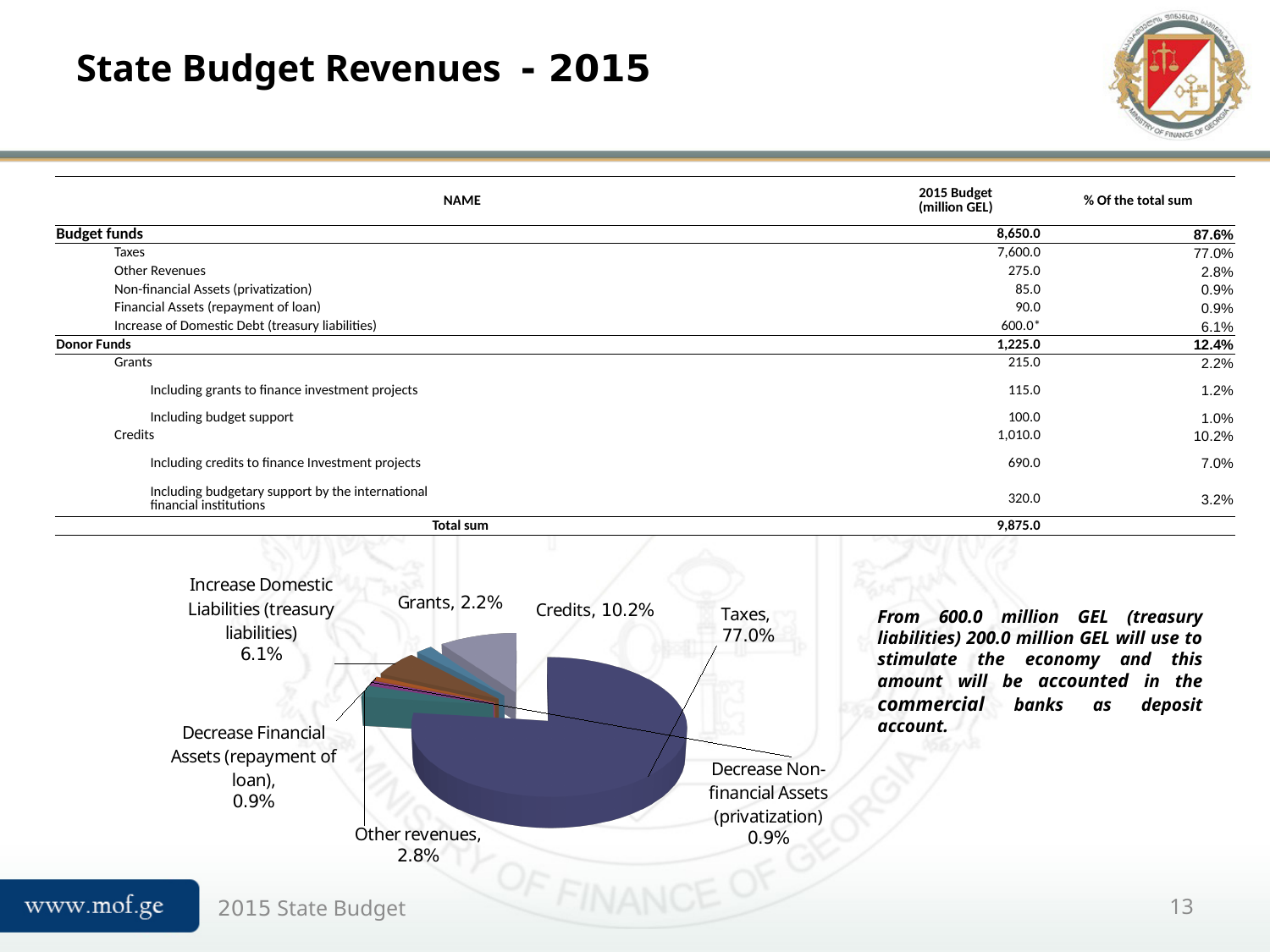
How many slices does the pie chart have? 7 In the pie chart, which is larger: Credits or Grants? Credits What share of the pie chart does Grants represent? 2.2% What is the combined share of Grants and Credits in the pie chart? 12.4% What share of the pie chart does Other revenues represent? 2.8% Which slice of the pie chart is the largest? Taxes What type of chart is shown on the slide? Pie chart What share of the pie chart does Credits represent? 10.2% What share of the pie chart does Taxes represent? 77.0% What is the difference in percentage points between the Taxes slice and the Credits slice in the pie chart? 66.8 What share of the pie chart does Increase Domestic Liabilities (treasury liabilities) represent? 6.1% What share of the pie chart does Decrease Non-financial Assets (privatization) represent? 0.9%